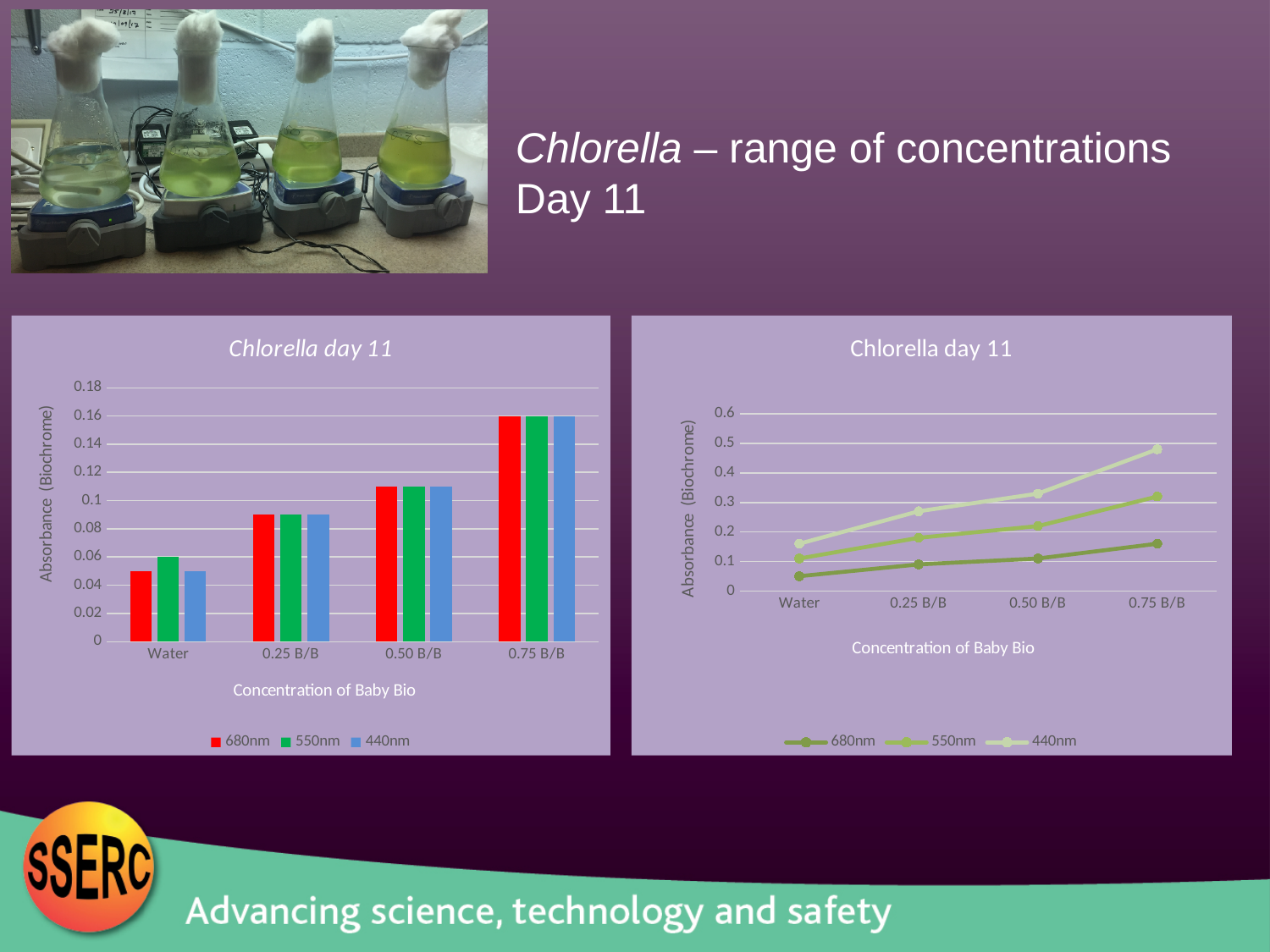
In the left chart, which concentration of Baby Bio has the lowest 440nm bar? Water What is the x-axis title of the left chart? Concentration of Baby Bio In the right chart, at 0.75 B/B, which series has the higher absorbance, 440nm or 680nm? 440nm In the right chart, is the 440nm value at 0.75 B/B greater or less than 0.4? greater In the right chart, how many concentration categories are shown on the x axis? 4 What kind of chart is the chart on the left of the slide? bar chart What kind of chart is the chart on the right of the slide? line chart In the left chart, how many series does the legend list? 3 In the left chart, which concentration of Baby Bio has the highest 680nm bar? 0.75 B/B In the right chart, does the 440nm line rise or fall as the concentration of Baby Bio increases from Water to 0.75 B/B? rise In the right chart, is the 680nm value for Water greater or less than 0.1? less In the left chart, is the 680nm bar for 0.75 B/B greater or less than 0.14? greater